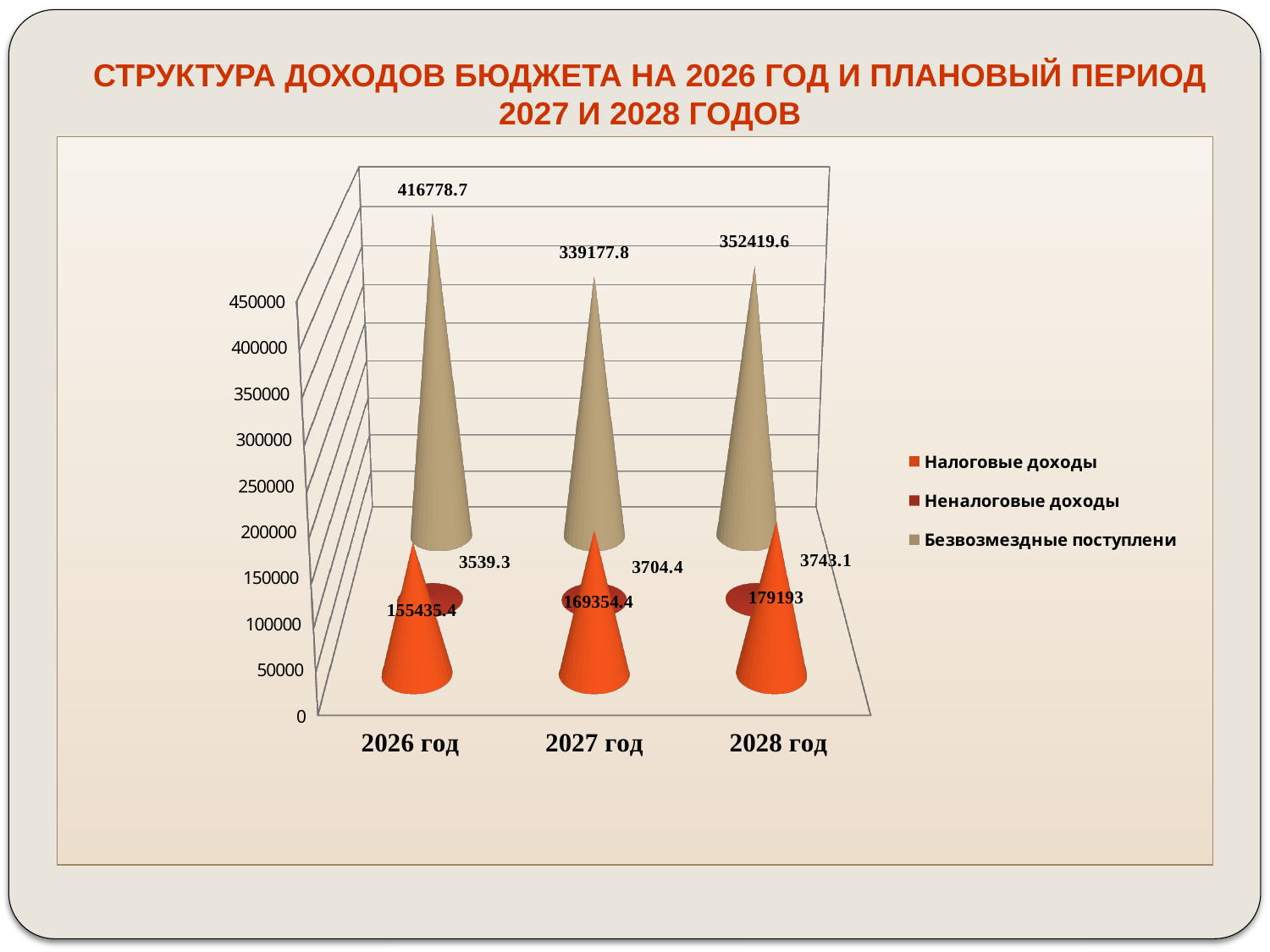
In which year is the value of Безвозмездные поступления highest? 2026 год Which is larger: Безвозмездные поступления in 2027 год or in 2028 год? 2028 год What is the value of Налоговые доходы for 2028 год? 179193 Do the values of Налоговые доходы rise or fall from 2026 год to 2028 год? rise In which year is the value of Налоговые доходы lowest? 2026 год What is the value of Безвозмездные поступления for 2027 год? 339177.8 What is the value of Неналоговые доходы for 2028 год? 3743.1 By how much do Налоговые доходы in 2028 год exceed those in 2026 год? 23757.6 What is the value of Налоговые доходы for 2026 год? 155435.4 How many series does the legend list? 3 How many years are shown on the x axis? 3 What is the difference between Безвозмездные поступления in 2026 год and 2027 год? 77600.9